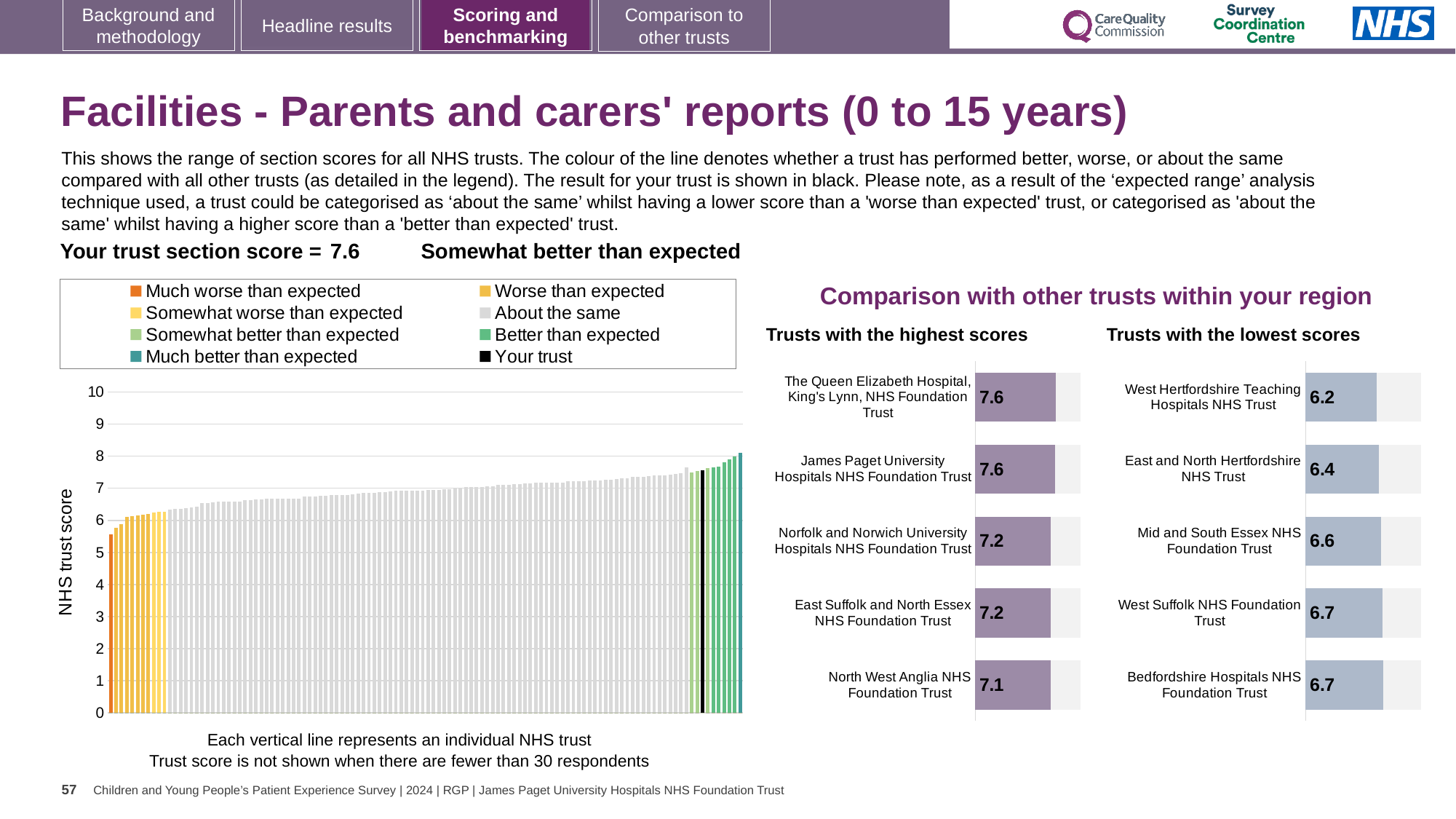
In the main 'NHS trust score' chart, do the trust scores rise or fall from left to right? Rise In the 'Trusts with the lowest scores' chart, what is the score for West Hertfordshire Teaching Hospitals NHS Trust? 6.2 In the 'Trusts with the lowest scores' chart, which trust has the lowest score? West Hertfordshire Teaching Hospitals NHS Trust In the main 'NHS trust score' chart, is the value of the black 'Your trust' bar greater or less than 7? greater How many entries does the legend of the main 'NHS trust score' chart list? 8 In the 'Trusts with the highest scores' chart, what is the score for Norfolk and Norwich University Hospitals NHS Foundation Trust? 7.2 In the 'Trusts with the highest scores' chart, which trust has the lowest score? North West Anglia NHS Foundation Trust How many trusts are shown in the 'Trusts with the highest scores' chart? 5 What kind of chart is the main 'NHS trust score' chart on the left? Bar chart In the 'Trusts with the lowest scores' chart, which has the higher score: Mid and South Essex NHS Foundation Trust or East and North Hertfordshire NHS Trust? Mid and South Essex NHS Foundation Trust In the 'Trusts with the highest scores' chart, what is the difference between the scores of The Queen Elizabeth Hospital, King's Lynn, NHS Foundation Trust and North West Anglia NHS Foundation Trust? 0.5 In the 'Trusts with the lowest scores' chart, what is the difference between the scores of Bedfordshire Hospitals NHS Foundation Trust and West Hertfordshire Teaching Hospitals NHS Trust? 0.5